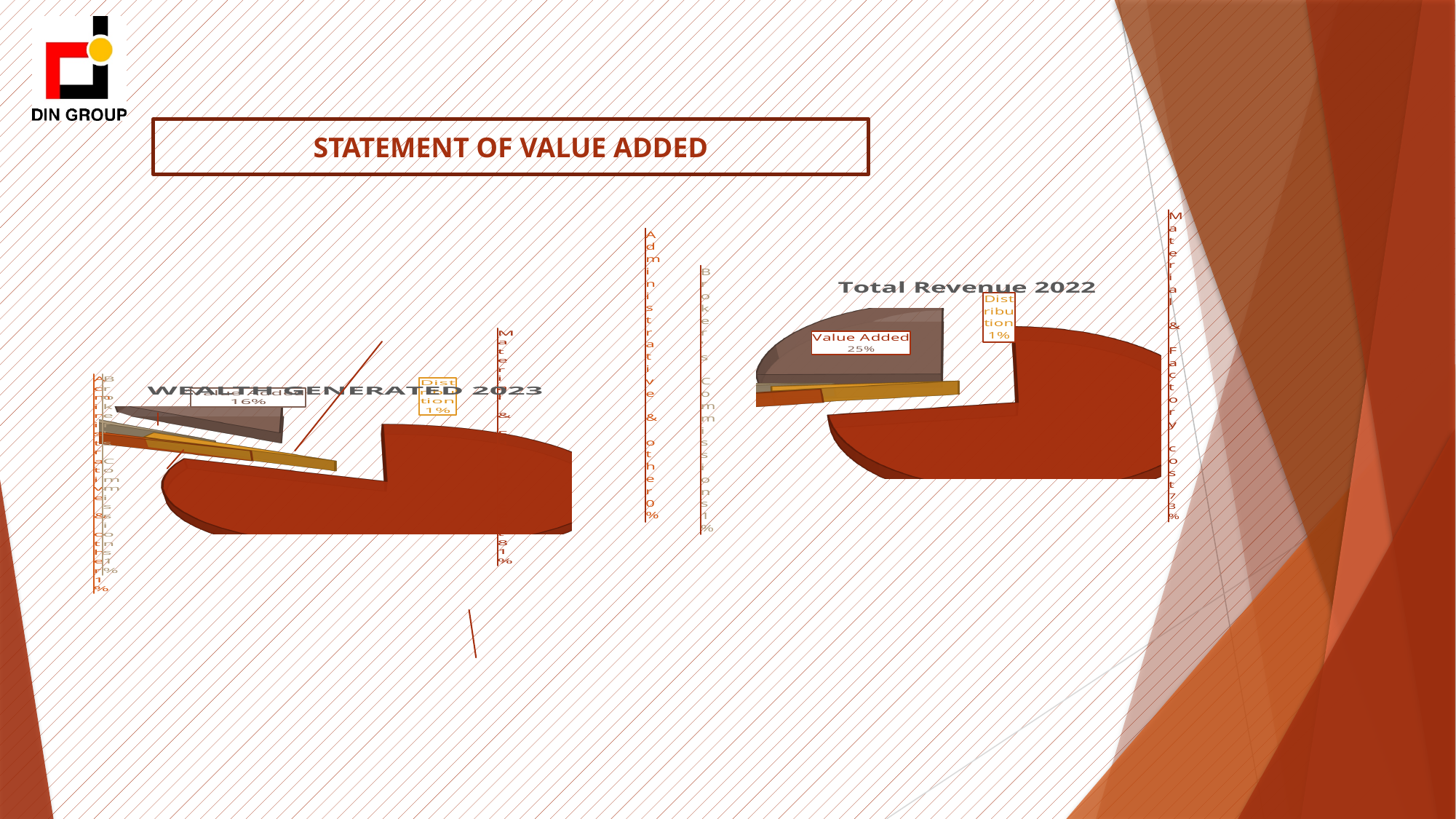
In the "WEALTH GENERATED 2023" chart, what share is Distribution? 1% In the "Total Revenue 2022" chart, what share is Distribution? 1% In the "Total Revenue 2022" chart, what share is Value Added? 25% By how many percentage points does the Material & Factory cost share in the "WEALTH GENERATED 2023" chart exceed that in the "Total Revenue 2022" chart? 8 percentage points What is the title of the chart on the left of the slide? WEALTH GENERATED 2023 What kind of chart is the "Total Revenue 2022" chart? Pie chart Is the Value Added share larger in the "WEALTH GENERATED 2023" chart or the "Total Revenue 2022" chart? Total Revenue 2022 In the "Total Revenue 2022" chart, which slice is the largest? Material & Factory cost